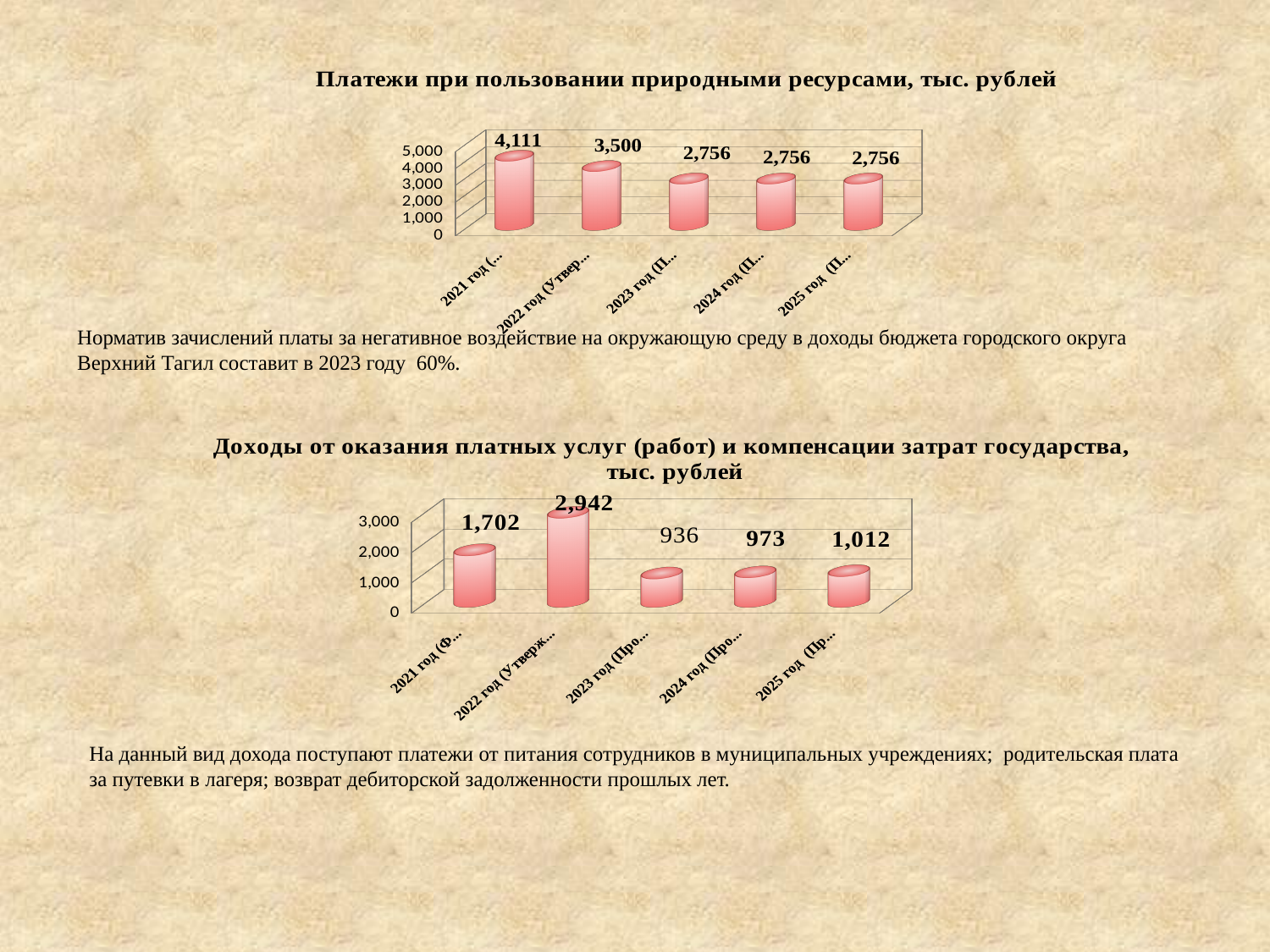
In the bottom chart 'Доходы от оказания платных услуг', what is the value for 2022 год? 2,942 What type of chart is the bottom chart 'Доходы от оказания платных услуг'? bar chart In the bottom chart 'Доходы от оказания платных услуг', which year has the lowest value? 2023 год In the top chart 'Платежи при пользовании природными ресурсами', which year has the highest value? 2021 год In the top chart 'Платежи при пользовании природными ресурсами', do the values rise or fall from 2021 to 2023? fall In the top chart 'Платежи при пользовании природными ресурсами', how many bars are plotted? 5 In the top chart 'Платежи при пользовании природными ресурсами', what is the value for 2021 год? 4,111 In the bottom chart 'Доходы от оказания платных услуг', what is the difference between the 2022 год and 2021 год values? 1,240 In the top chart 'Платежи при пользовании природными ресурсами', what is the value for 2022 год? 3,500 In the bottom chart 'Доходы от оказания платных услуг', what is the value for 2023 год? 936 In the bottom chart 'Доходы от оказания платных услуг', which is larger: the value for 2021 год or 2025 год? 2021 год In the top chart 'Платежи при пользовании природными ресурсами', what is the difference between the 2021 год and 2022 год values? 611